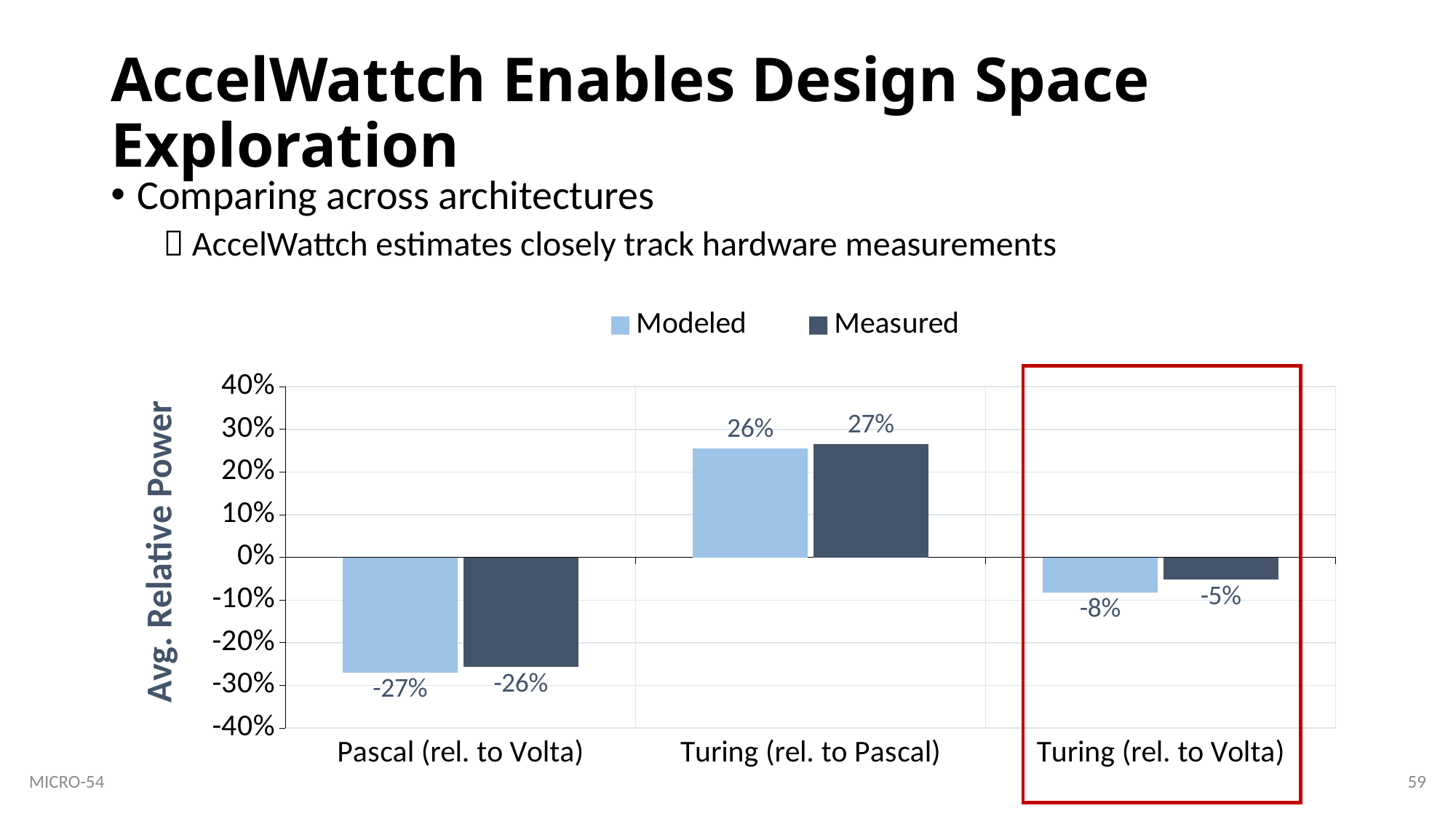
What is the Measured value for Turing (rel. to Volta)? -5% How many categories are shown on the x axis? 3 What kind of chart is shown on the slide? Bar chart Which category has the highest Measured value? Turing (rel. to Pascal) For Pascal (rel. to Volta), which is larger, the Modeled or the Measured value? Measured What is the Modeled value for Turing (rel. to Volta)? -8% Which category has the lowest Modeled value? Pascal (rel. to Volta) What is the difference between the Modeled and Measured values for Turing (rel. to Volta)? 3% What is the label of the y axis? Avg. Relative Power What is the Modeled value for Pascal (rel. to Volta)? -27% How many series does the legend list? 2 What is the Measured value for Turing (rel. to Pascal)? 27%